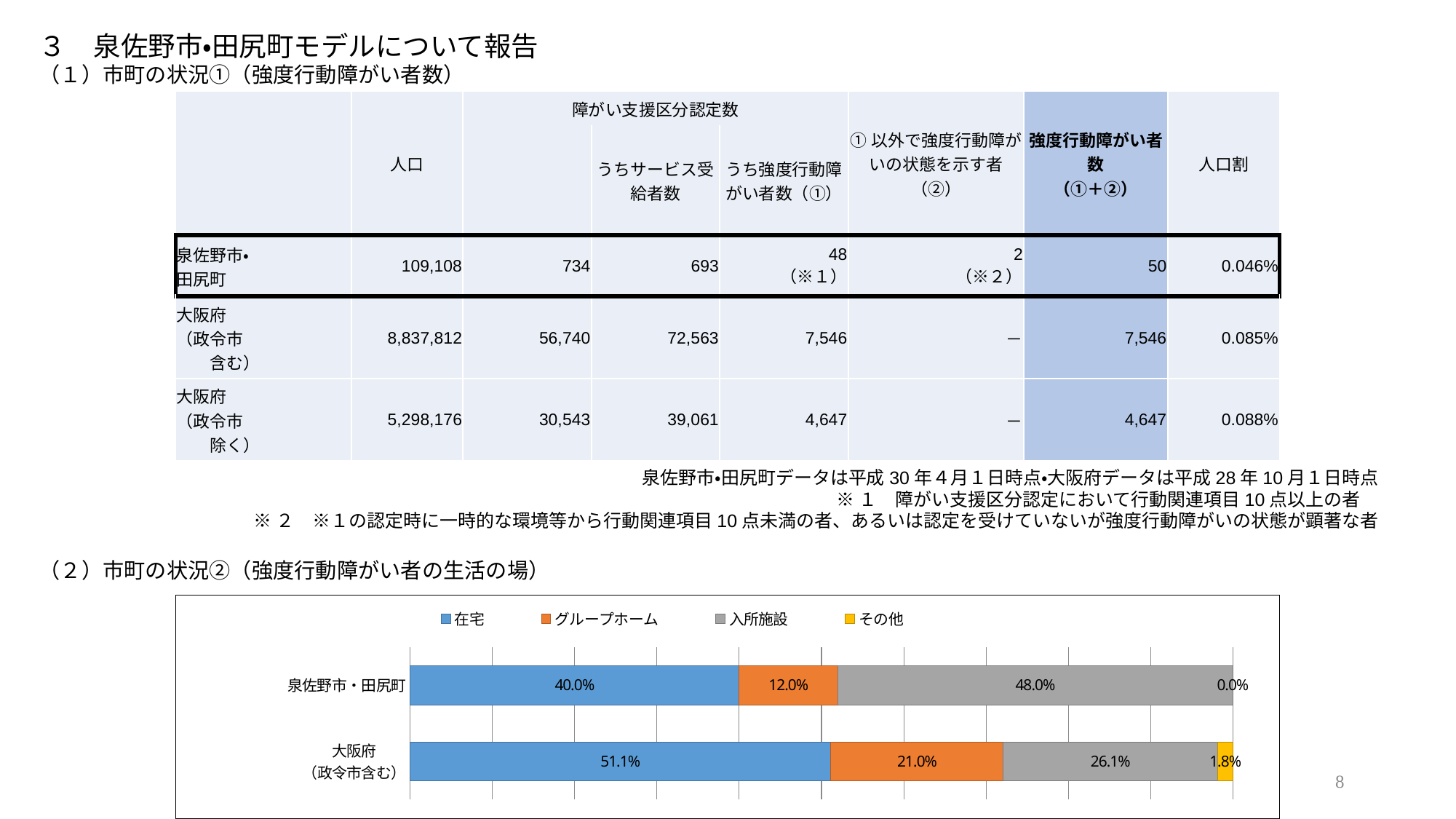
In the bottom chart, what is the 在宅 value for 泉佐野市・田尻町? 40.0% In the bottom chart, how many series does the legend list? 4 In the bottom chart, what is the difference between the 入所施設 values for 泉佐野市・田尻町 and 大阪府（政令市含む）? 21.9% In the bottom chart, what is the その他 value for 大阪府（政令市含む）? 1.8% In the bottom chart, which has the larger 在宅 share, 泉佐野市・田尻町 or 大阪府（政令市含む）? 大阪府（政令市含む） What kind of chart is shown at the bottom of the slide? Stacked bar chart In the bottom chart, what colour represents グループホーム in the legend? Orange In the bottom chart, which segment is the largest for 大阪府（政令市含む）? 在宅 In the bottom chart, what is the グループホーム value for 大阪府（政令市含む）? 21.0% In the bottom chart, what is the 入所施設 value for 泉佐野市・田尻町? 48.0% In the bottom chart, how many categories (bars) are plotted? 2 In the bottom chart, which segment is the largest for 泉佐野市・田尻町? 入所施設